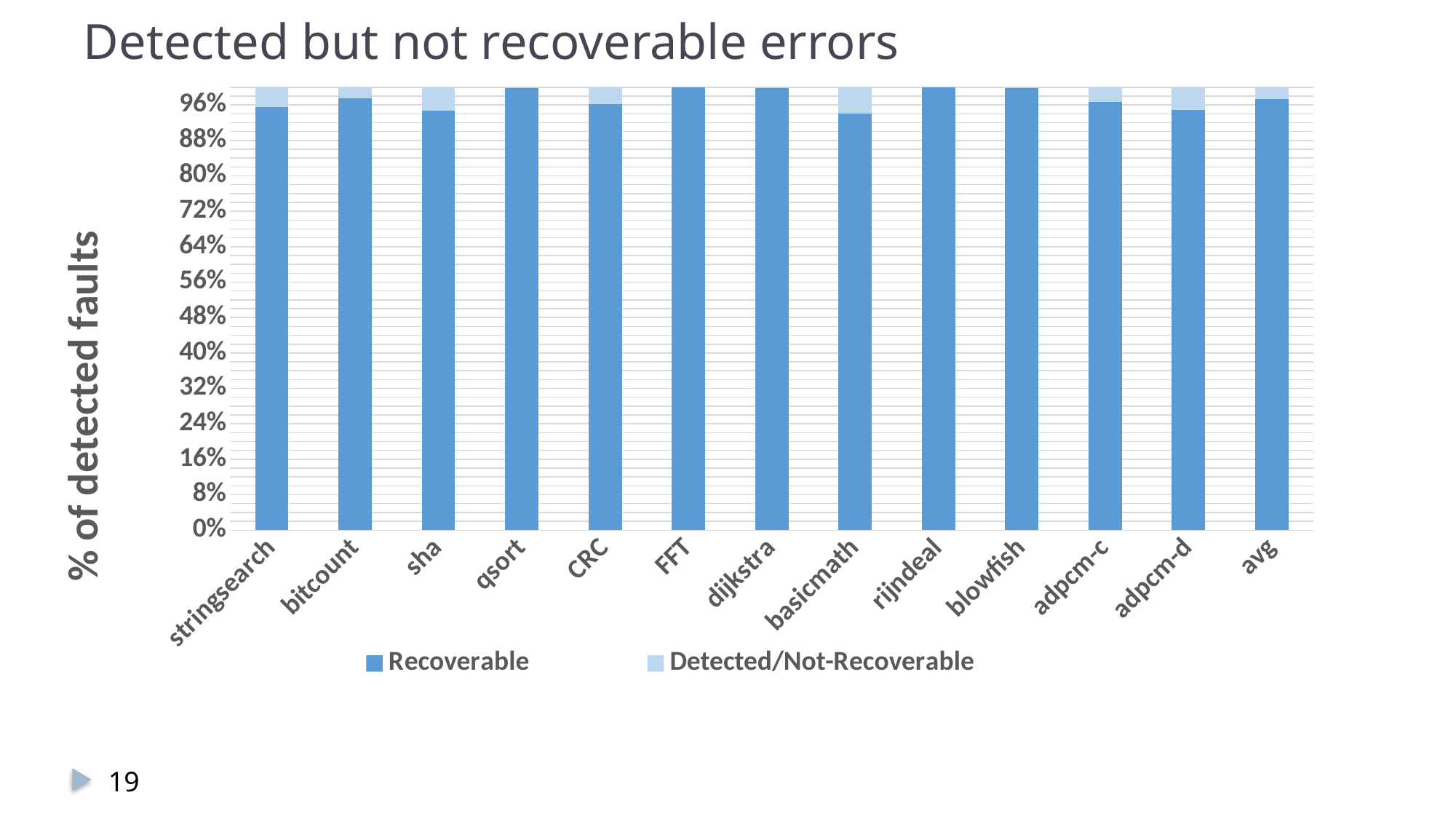
How many categories are plotted along the x axis? 13 Is the Recoverable value for CRC greater or less than 80%? greater What is the last category on the x axis? avg How many series does the legend list? 2 Which has a larger Recoverable value, basicmath or FFT? FFT What kind of chart is shown on the slide? bar chart What is the label on the y axis? % of detected faults Is the Detected/Not-Recoverable value for stringsearch greater or less than 8%? less Which has a larger Detected/Not-Recoverable value, basicmath or qsort? basicmath Is the Recoverable value for basicmath greater or less than 88%? greater What are the two series named in the legend? Recoverable and Detected/Not-Recoverable